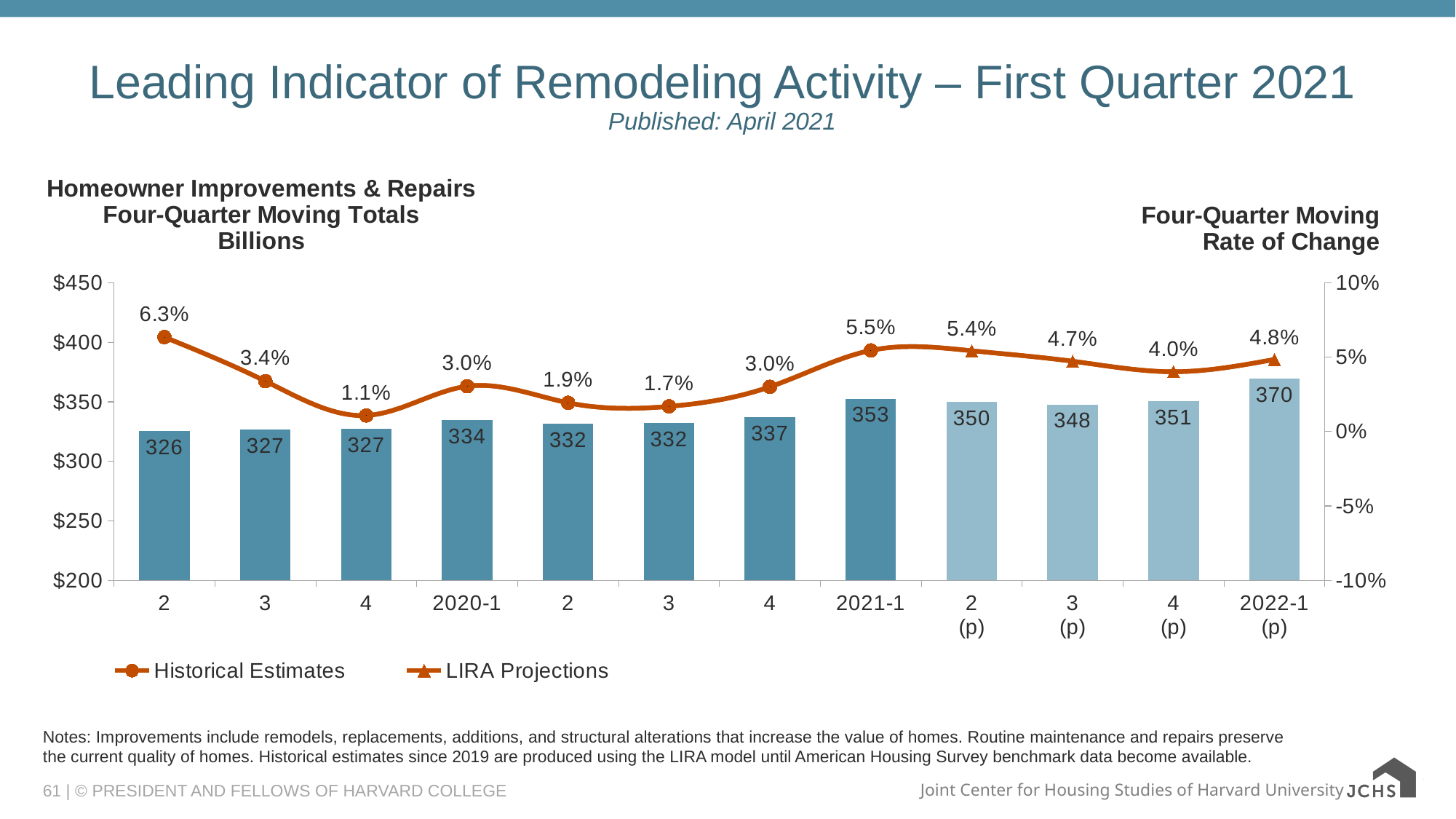
Is the four-quarter moving total bar for 2022-1 (p) greater or less than $350? greater Which has the larger four-quarter moving total: 2021-1 or 2 (p)? 2021-1 How many quarters are shown along the x axis? 12 Does the four-quarter moving rate of change rise or fall from 2021-1 to 4 (p)? Fall How many series does the legend list? 2 What are the two entries in the chart legend? Historical Estimates and LIRA Projections What kind of chart is shown on the slide? Combination bar and line chart What is the four-quarter moving total (in billions) for 2021-1? 353 What is the difference between the four-quarter moving total for 2022-1 (p) and for 2021-1? 17 What is the four-quarter moving rate of change for 2020-1? 3.0% Which period has the highest four-quarter moving total bar? 2022-1 (p) What is the lowest four-quarter moving rate of change shown on the line? 1.1%